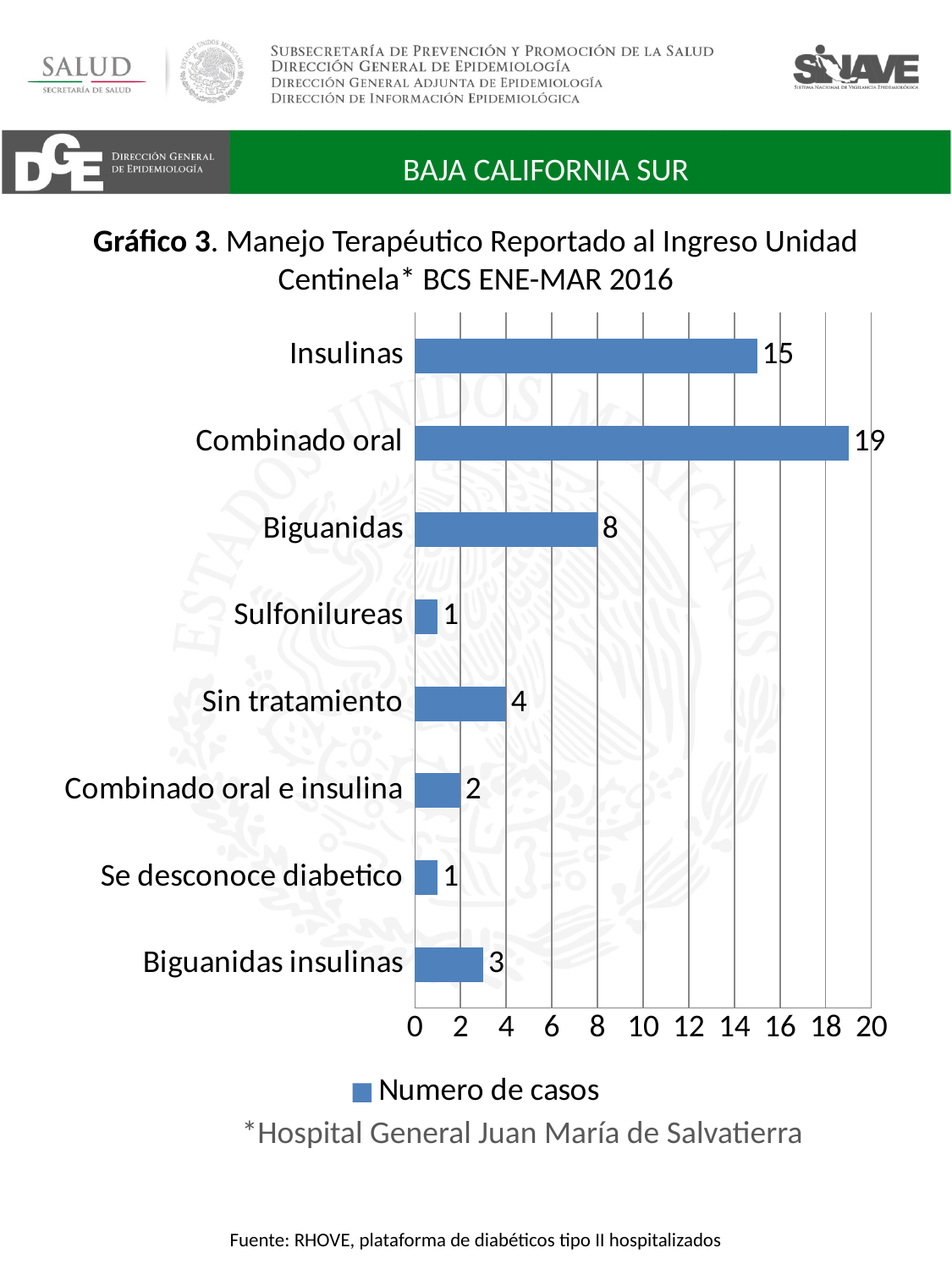
What is the legend entry for the series shown in the chart? Numero de casos How many series does the legend list? 1 What is the number of cases for Biguanidas? 8 What is the number of cases for Insulinas? 15 How many categories are shown in the chart? 8 Which has more cases, Biguanidas or Biguanidas insulinas? Biguanidas Which category has the highest number of cases? Combinado oral What kind of chart is shown on the slide? Bar chart What is the difference in number of cases between Biguanidas and Sin tratamiento? 4 What is the difference in number of cases between Combinado oral and Insulinas? 4 What is the number of cases for Combinado oral e insulina? 2 What is the number of cases for Sin tratamiento? 4